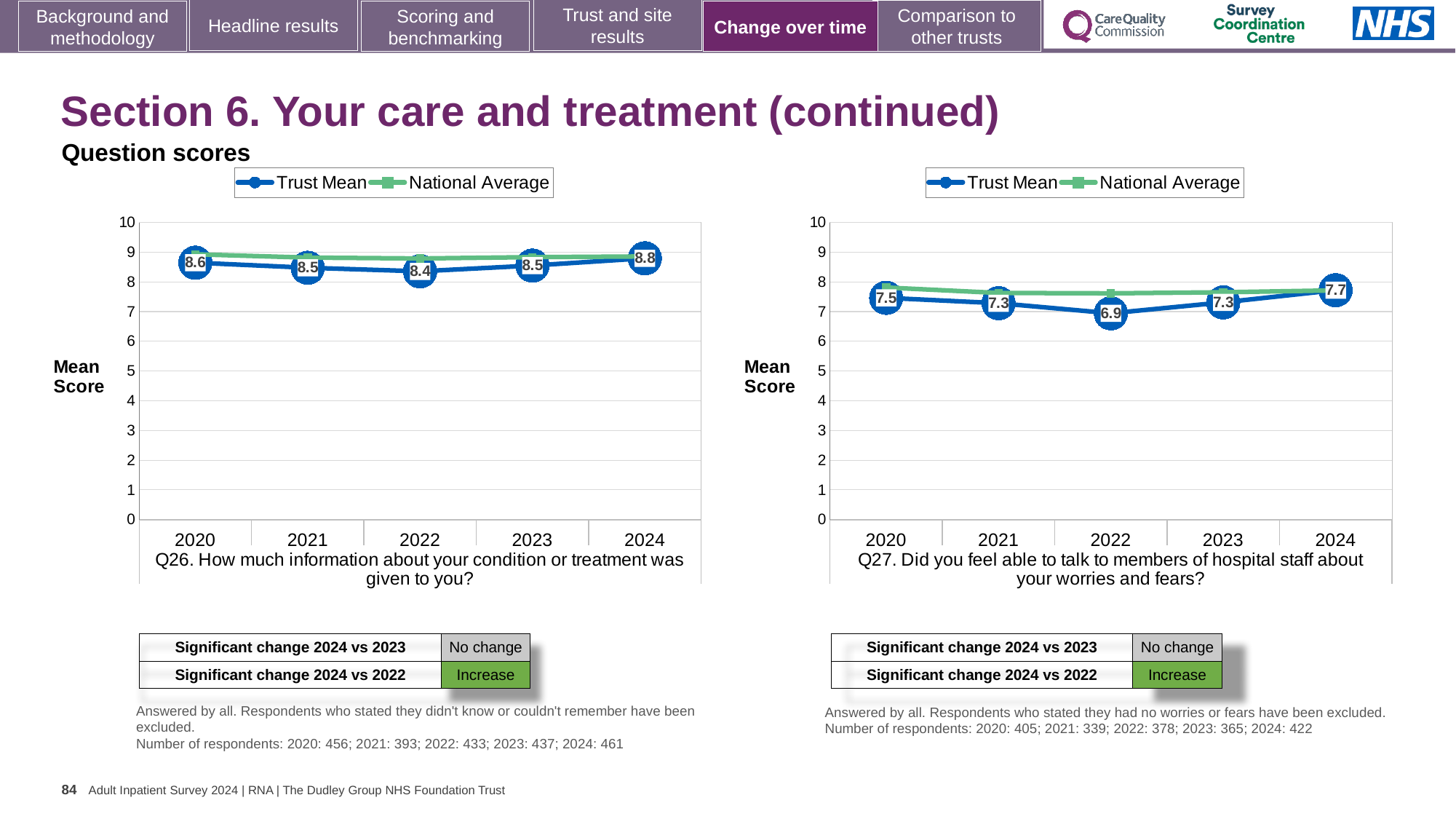
In the Q26 chart (left), what is the difference between the Trust Mean scores for 2024 and 2022? 0.4 In the Q27 chart (right), what does the legend call the green series? National Average In the Q26 chart (left), which year has the lowest Trust Mean score? 2022 How many years are shown on the x axis of the Q27 chart (right)? 5 How many series does the legend of the Q26 chart (left) list? 2 In the Q27 chart (right), what is the difference between the Trust Mean scores for 2024 and 2022? 0.8 In the Q27 chart (right), which year has the highest Trust Mean score? 2024 In the Q26 chart (left), is the Trust Mean value for 2021 greater or less than 8? greater What type of chart is the Q26 chart (left)? line chart In the Q26 chart (left), what is the Trust Mean score for 2024? 8.8 In the Q27 chart (right), is the Trust Mean score for 2020 higher or lower than for 2022? higher In the Q27 chart (right), what is the Trust Mean score for 2022? 6.9